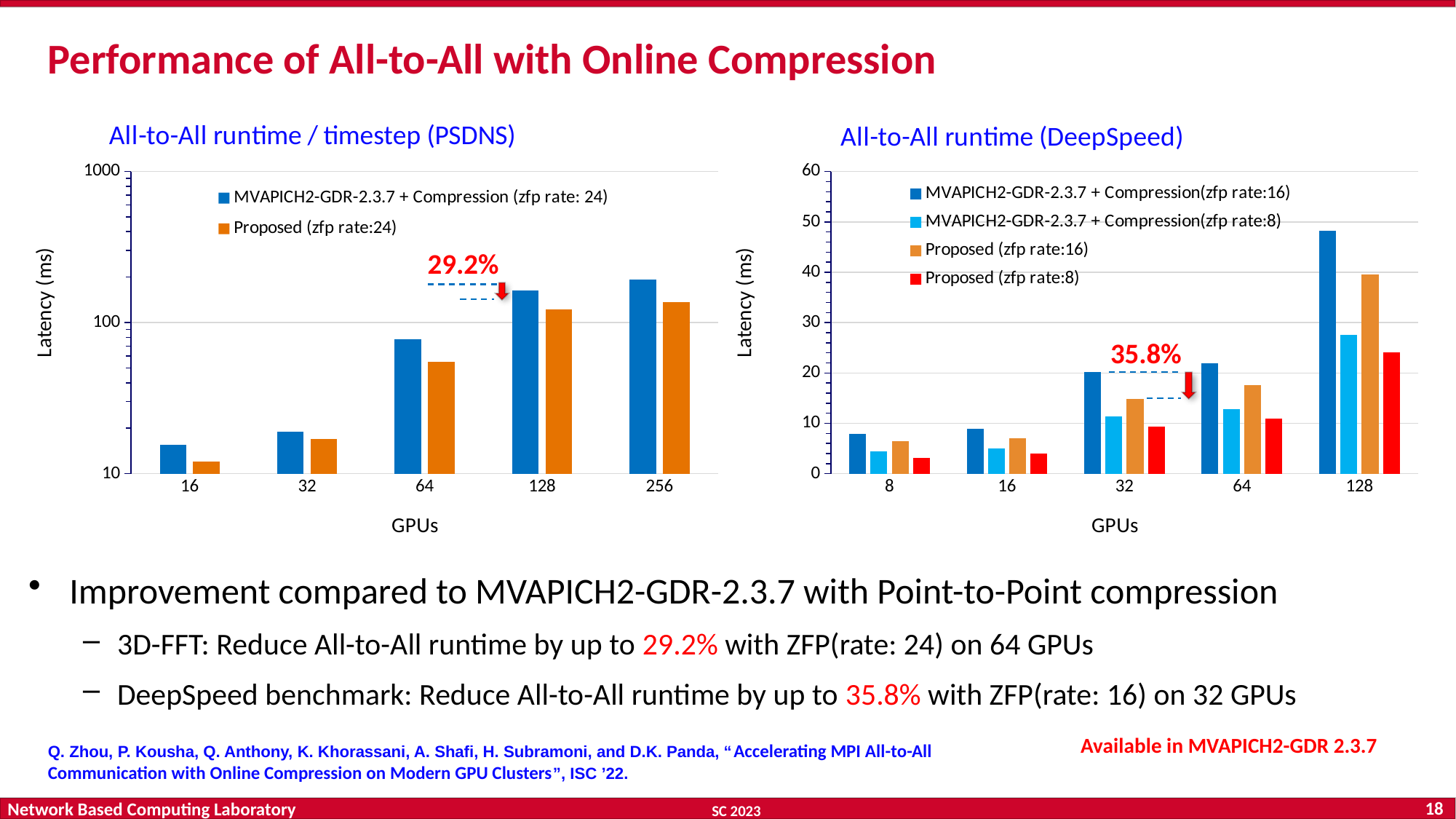
In the All-to-All runtime (DeepSpeed) chart, is the Proposed (zfp rate:8) value at 8 GPUs greater or less than 10? less In the All-to-All runtime / timestep (PSDNS) chart, is the MVAPICH2-GDR-2.3.7 + Compression (zfp rate: 24) value at 128 GPUs greater or less than 100? greater In the All-to-All runtime (DeepSpeed) chart, is the MVAPICH2-GDR-2.3.7 + Compression(zfp rate:16) value at 128 GPUs greater or less than 40? greater In the All-to-All runtime (DeepSpeed) chart, do the Proposed (zfp rate:8) values rise or fall as the number of GPUs increases? rise In the All-to-All runtime (DeepSpeed) chart, at 128 GPUs, which is larger: MVAPICH2-GDR-2.3.7 + Compression(zfp rate:16) or Proposed (zfp rate:16)? MVAPICH2-GDR-2.3.7 + Compression(zfp rate:16) What percentage improvement is annotated on the All-to-All runtime (DeepSpeed) chart? 35.8% In the All-to-All runtime / timestep (PSDNS) chart, at which GPU count is the Proposed (zfp rate:24) bar lowest? 16 How many series does the legend of the All-to-All runtime / timestep (PSDNS) chart list? 2 How many GPU counts are shown on the x axis of the All-to-All runtime (DeepSpeed) chart? 5 What kind of chart is the All-to-All runtime / timestep (PSDNS) chart? bar chart In the All-to-All runtime / timestep (PSDNS) chart, at which GPU count is the MVAPICH2-GDR-2.3.7 + Compression (zfp rate: 24) bar highest? 256 How many series does the legend of the All-to-All runtime (DeepSpeed) chart list? 4